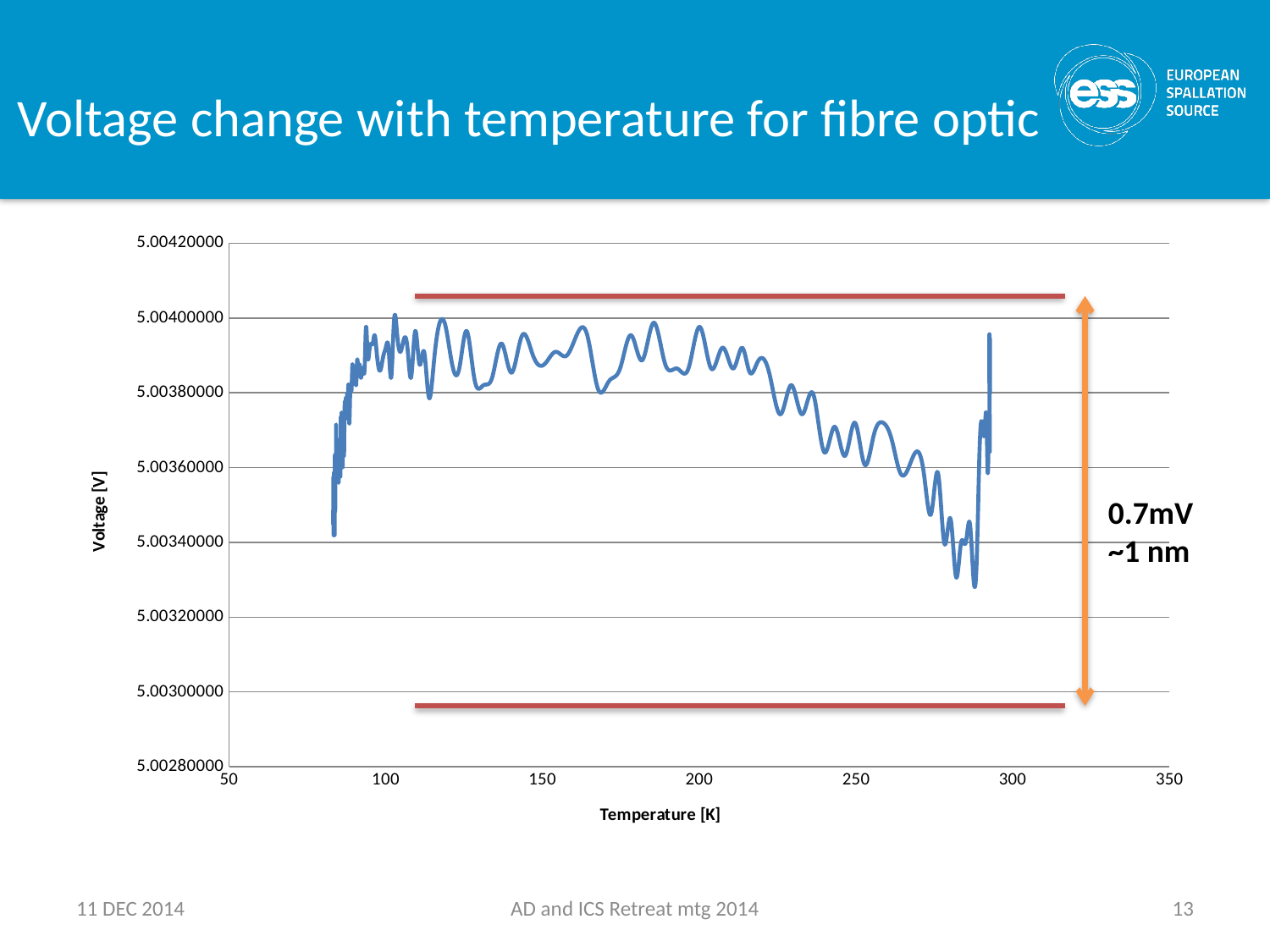
What voltage span is indicated by the orange arrow annotation on the chart? 0.7mV Does the voltage rise or fall as temperature increases from about 85 K to 100 K? rise What kind of chart is shown on the slide? line chart Is the voltage at 200 K greater or less than 5.00380000? greater Does the voltage generally rise or fall as temperature increases from 200 K to 280 K? fall Is the lowest voltage on the curve greater or less than 5.00340000? less Is the highest voltage on the curve greater or less than 5.00420000? less What is the title of the slide's chart? Voltage change with temperature for fibre optic Is the voltage at 150 K larger or smaller than the voltage at 280 K? larger What is the label of the x axis? Temperature [K]